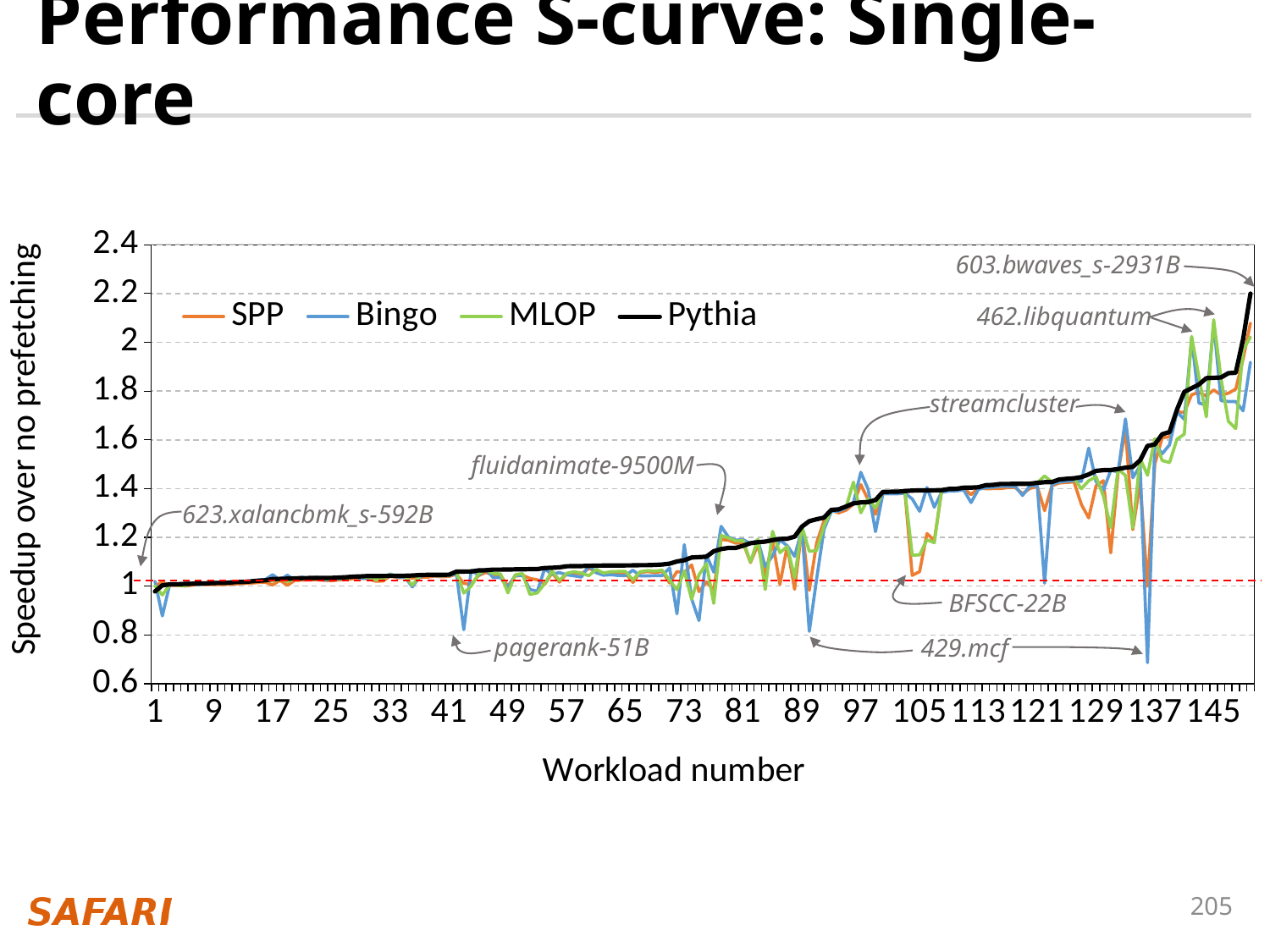
What kind of chart is shown on the slide? line chart Is the Pythia value at the workload annotated 603.bwaves_s-2931B greater or less than 2? greater Is the Bingo value at the workload annotated streamcluster greater or less than 1.4? greater Which series are listed in the legend? SPP, Bingo, MLOP, Pythia At the workload annotated 429.mcf, which series has the larger value, Pythia or Bingo? Pythia How many series does the legend list? 4 Does the Pythia line rise or fall as the workload number increases along the x axis? rise Is the Bingo value at the workload annotated pagerank-51B greater or less than 1? less What is the title of the y axis? Speedup over no prefetching Which series reaches the highest speedup at the right end of the chart? Pythia